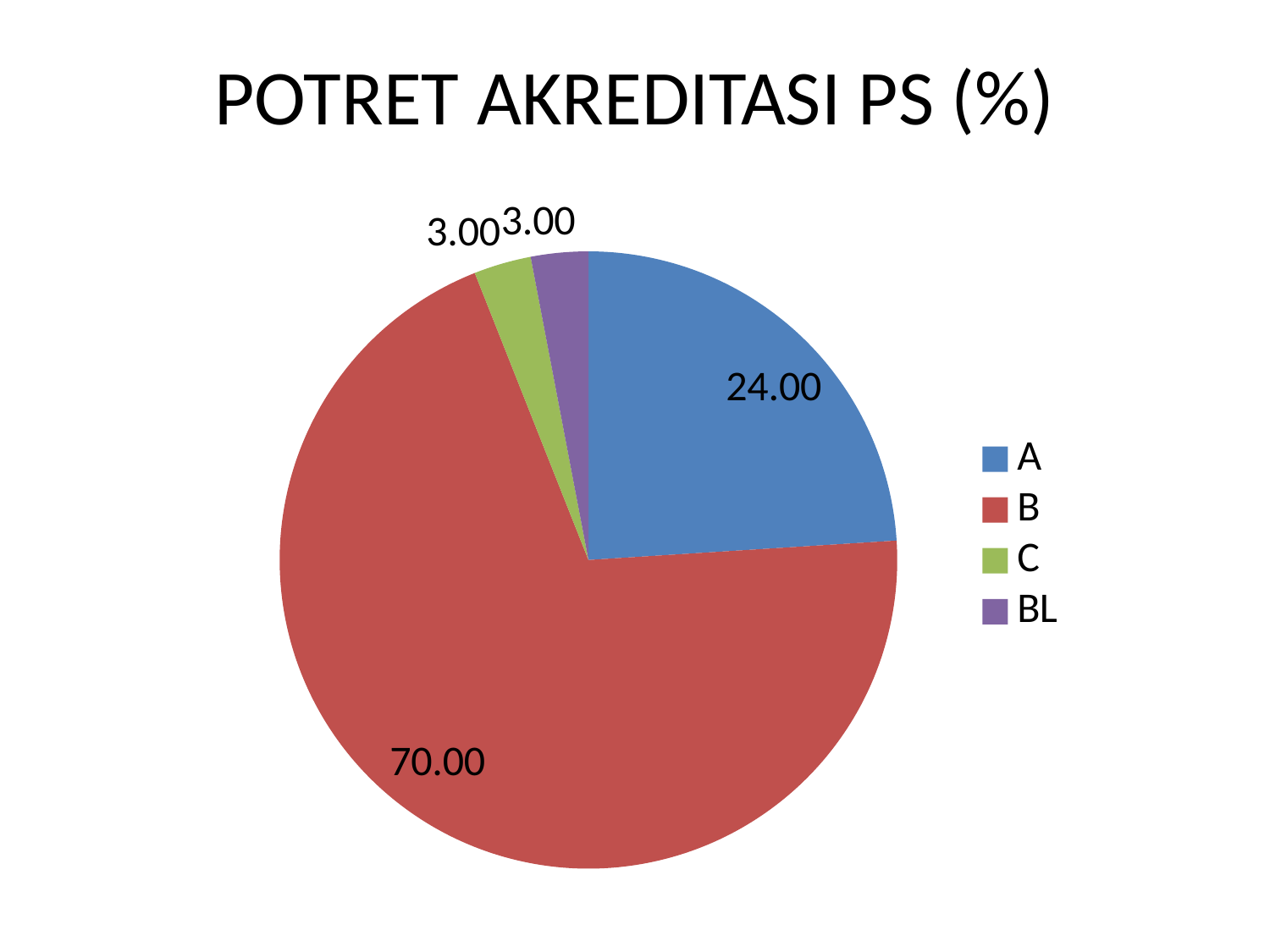
What is the value for category B in the pie chart? 70.00 What type of chart is shown on the slide? Pie chart What is the value for category BL in the pie chart? 3.00 What is the title of the chart? POTRET AKREDITASI PS (%) What is the value for category A in the pie chart? 24.00 What is the value for category C in the pie chart? 3.00 Which category has the largest slice of the pie? B What share of the pie does category B represent? 70.00% What is the difference between the values for A and C? 21.00 How many slices does the pie chart have? 4 Which is larger, the value for A or the value for BL? A What is the difference between the values for B and A? 46.00